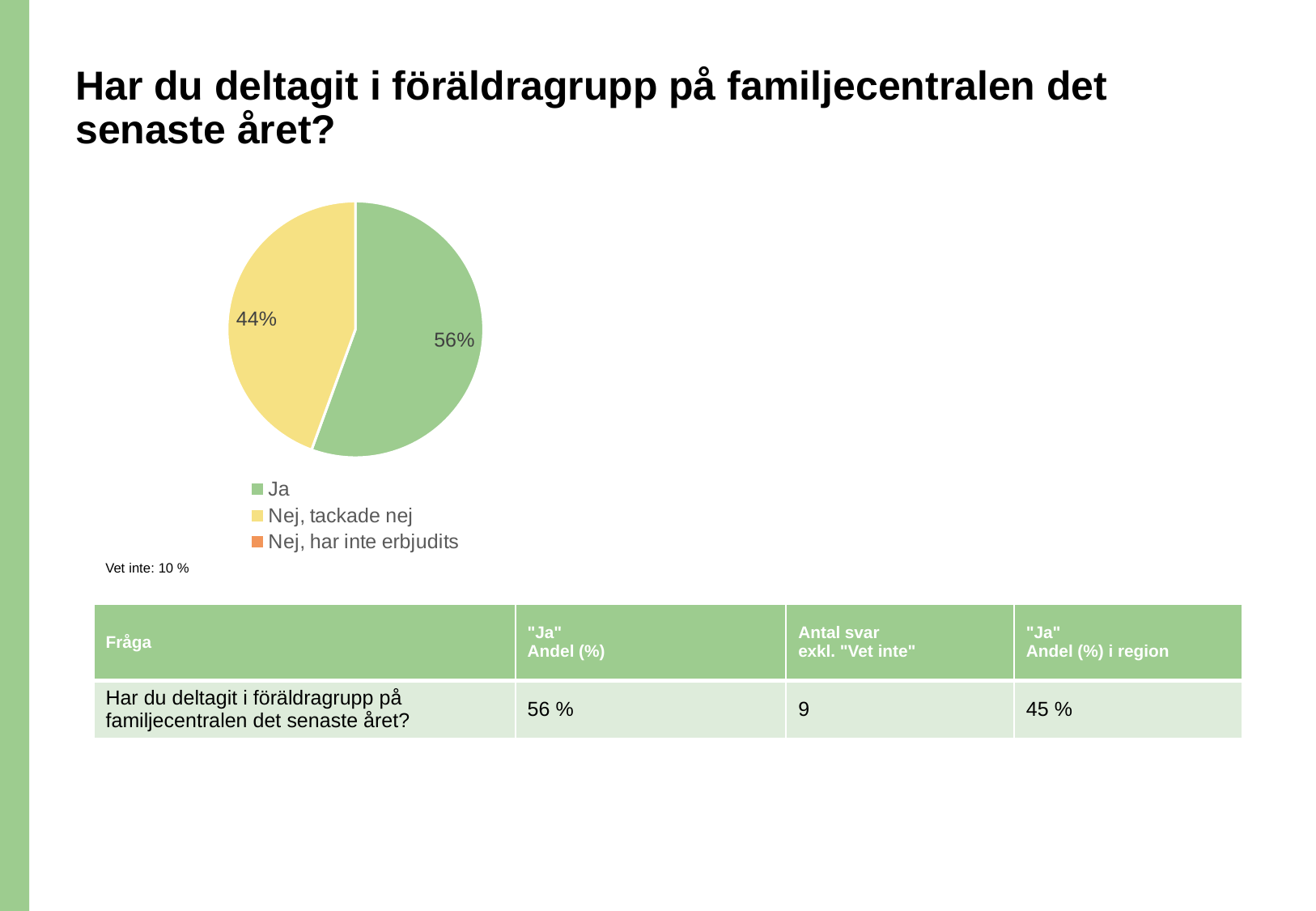
What colour is the "Ja" slice in the pie chart? Green What percentage of the pie chart is the "Ja" slice? 56% Which category has the largest slice in the pie chart? Ja How many entries does the pie chart's legend list? 3 Which legend entry is shown in yellow? Nej, tackade nej Is the "Ja" share in the pie chart greater or less than 50%? greater What percentage of the pie chart is the "Nej, tackade nej" slice? 44% According to the table, what is the "Ja" share in the region? 45 % What kind of chart is shown on the slide? Pie chart Which is larger in the pie chart, "Ja" or "Nej, tackade nej"? Ja What is the "Vet inte" percentage noted below the pie chart? 10 % What is the difference in percentage points between the "Ja" slice and the "Nej, tackade nej" slice? 12 percentage points